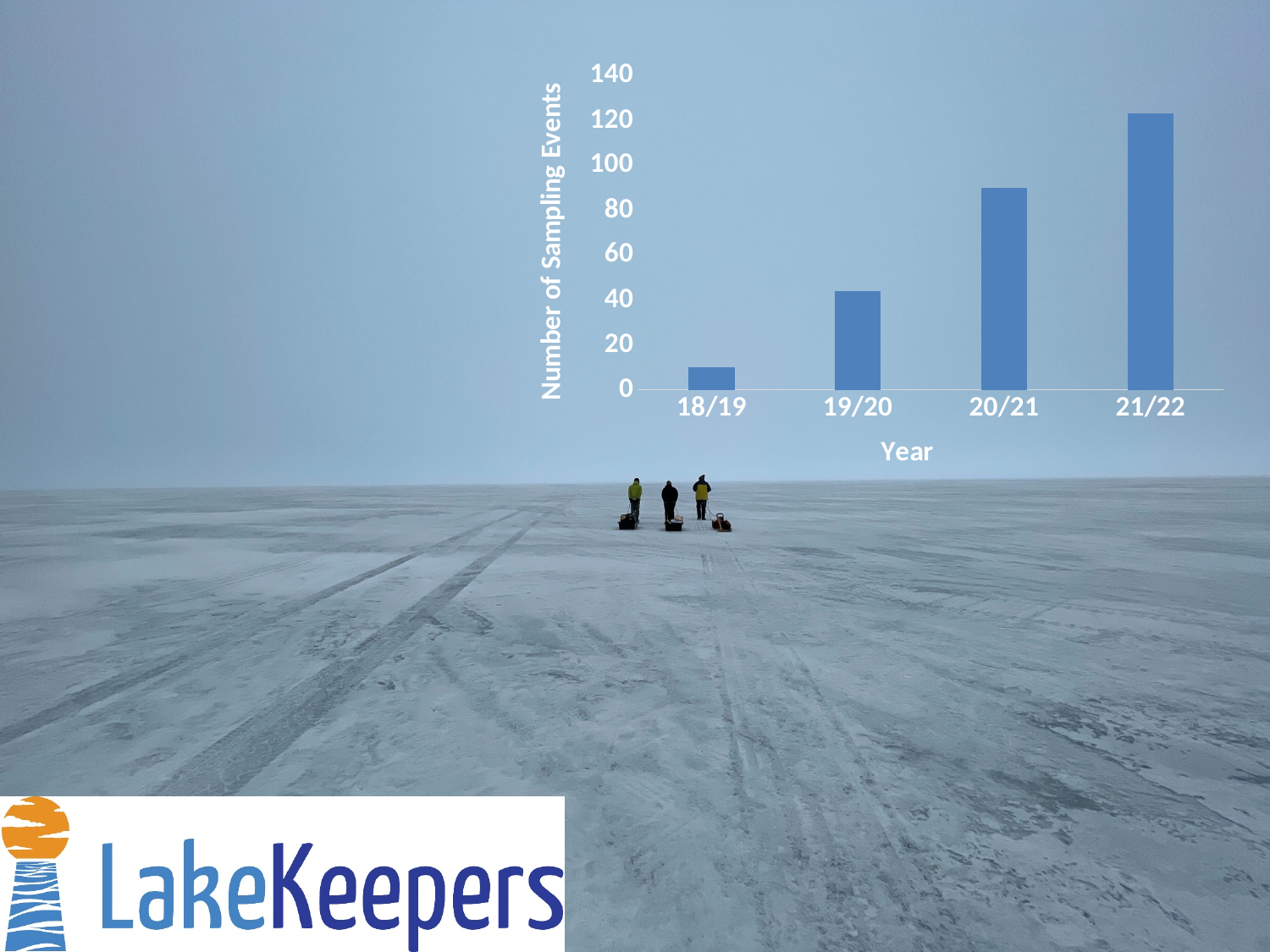
What kind of chart is shown on the slide? bar chart Is the number of sampling events for 20/21 greater or less than 80? greater Is the number of sampling events for 21/22 greater or less than 100? greater Is the number of sampling events for 19/20 greater or less than 60? less Which year has the lowest number of sampling events? 18/19 What is the label of the horizontal axis of the chart? Year Which year has more sampling events, 19/20 or 20/21? 20/21 What is the label of the vertical axis of the chart? Number of Sampling Events How many years are shown on the x axis of the chart? 4 Which year has the highest number of sampling events? 21/22 Do the number of sampling events rise or fall from 18/19 to 21/22? rise